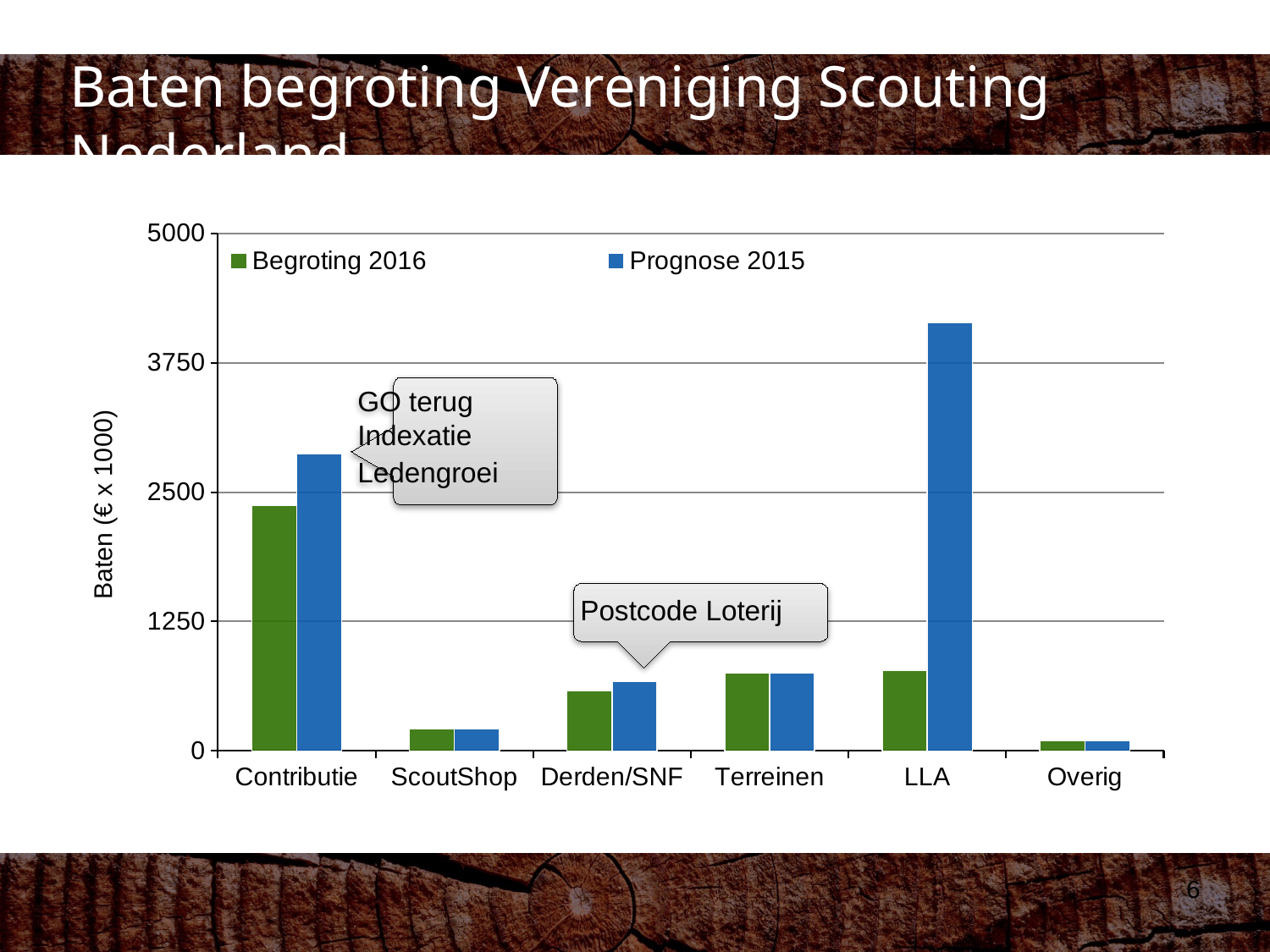
What is the label of the y axis? Baten (€ x 1000) Which category has the highest Prognose 2015 value? LLA Is the Begroting 2016 value for Contributie greater or less than 1250? greater Which category has the lowest Begroting 2016 value? Overig What kind of chart is shown on the slide? bar chart How many categories are shown on the x axis? 6 Is the Prognose 2015 value for ScoutShop greater or less than 1250? less Which category has the highest Begroting 2016 value? Contributie How many series does the legend list? 2 For LLA, which is larger: Begroting 2016 or Prognose 2015? Prognose 2015 Is the Prognose 2015 value for LLA greater or less than 3750? greater For Contributie, which is larger: Begroting 2016 or Prognose 2015? Prognose 2015